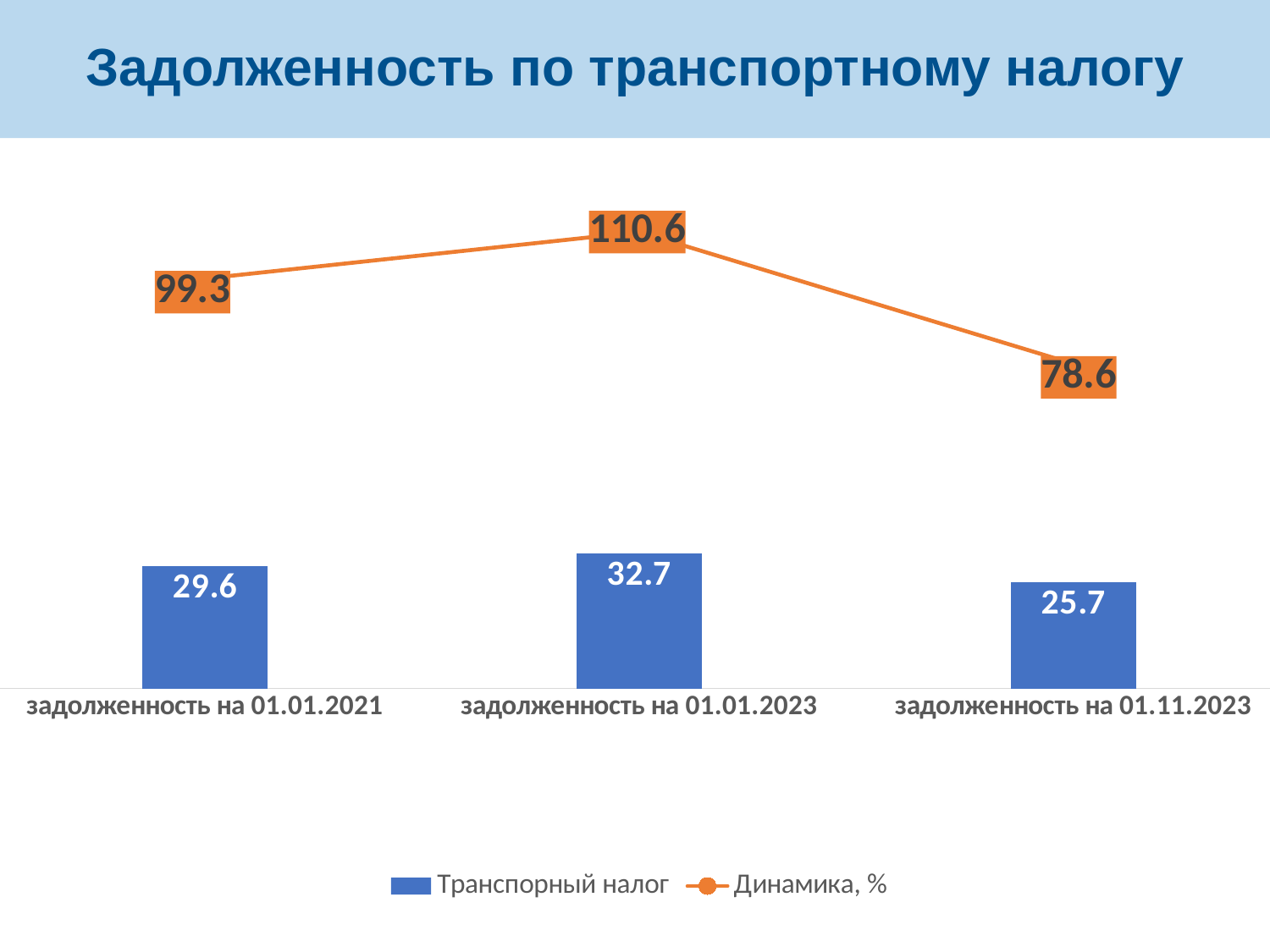
How many series does the legend list? 2 What is the value of the Транспорный налог bar for задолженность на 01.11.2023? 25.7 What is the Динамика, % value for задолженность на 01.11.2023? 78.6 What is the Динамика, % value for задолженность на 01.01.2023? 110.6 What is the title of the chart? Задолженность по транспортному налогу Which is larger: the Транспорный налог value for задолженность на 01.01.2021 or for задолженность на 01.11.2023? задолженность на 01.01.2021 What is the difference between the Динамика, % values for задолженность на 01.01.2023 and задолженность на 01.01.2021? 11.3 What is the value of the Транспорный налог bar for задолженность на 01.01.2021? 29.6 Which category has the lowest Динамика, % value? задолженность на 01.11.2023 Which category has the highest Транспорный налог value? задолженность на 01.01.2023 What is the difference between the Транспорный налог values for задолженность на 01.01.2023 and задолженность на 01.11.2023? 7.0 How many categories are shown on the x axis? 3